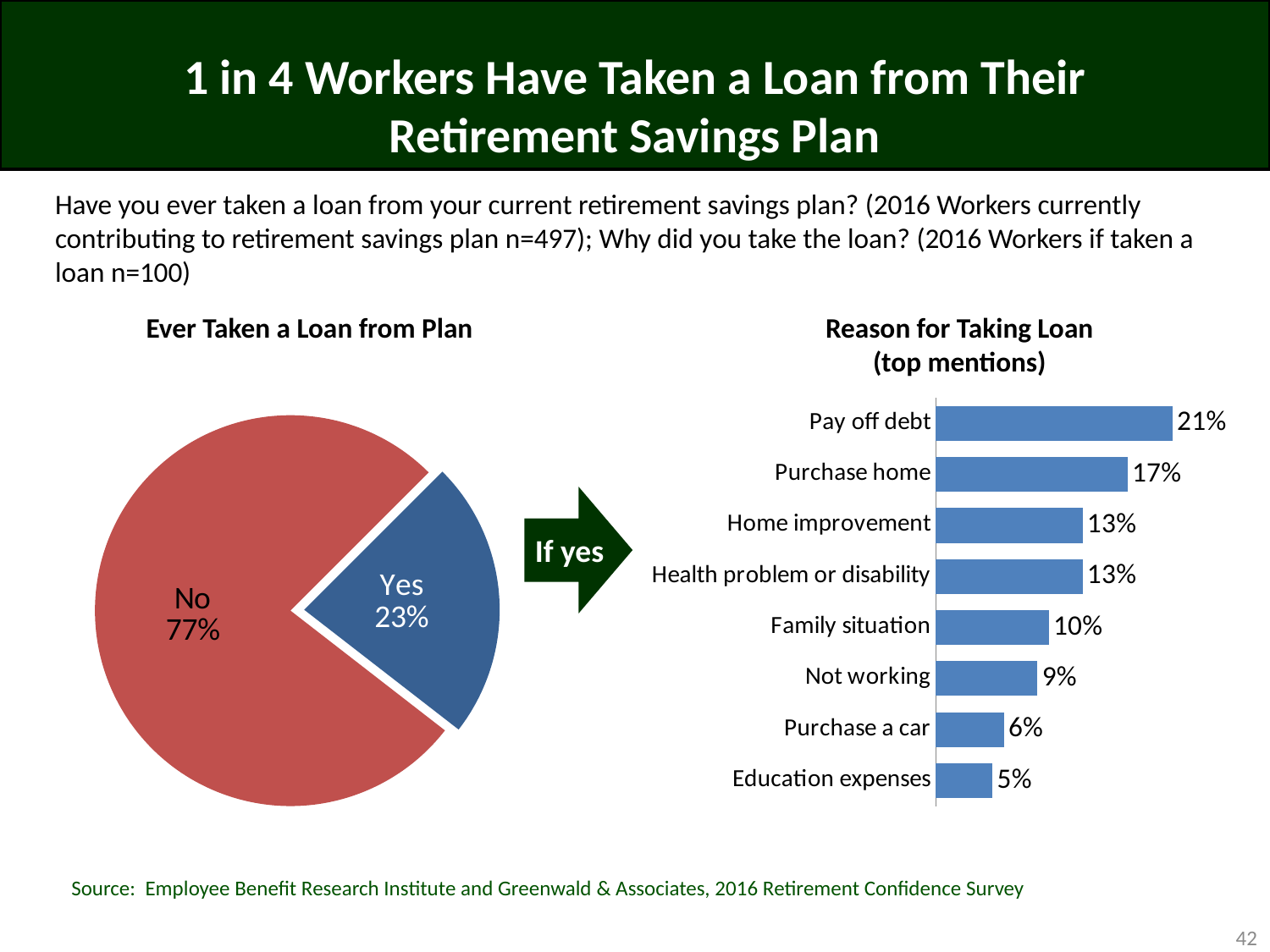
In the 'Reason for Taking Loan' chart, what is the value for Pay off debt? 21% In the 'Reason for Taking Loan' chart, what is the value for Family situation? 10% In the 'Reason for Taking Loan' chart, what is the value for Health problem or disability? 13% In the 'Reason for Taking Loan' chart, which is larger: Not working or Purchase a car? Not working In the 'Reason for Taking Loan' chart, what is the difference between Pay off debt and Purchase home? 4% What kind of chart is 'Reason for Taking Loan (top mentions)'? Bar chart In the 'Reason for Taking Loan' chart, which reason has the highest value? Pay off debt In the 'Reason for Taking Loan' chart, which reason has the lowest value? Education expenses How many reasons are listed in the 'Reason for Taking Loan' chart? 8 In the 'Ever Taken a Loan from Plan' chart, what share of workers answered Yes? 23% In the 'Ever Taken a Loan from Plan' chart, what share of workers answered No? 77% What kind of chart is 'Ever Taken a Loan from Plan'? Pie chart